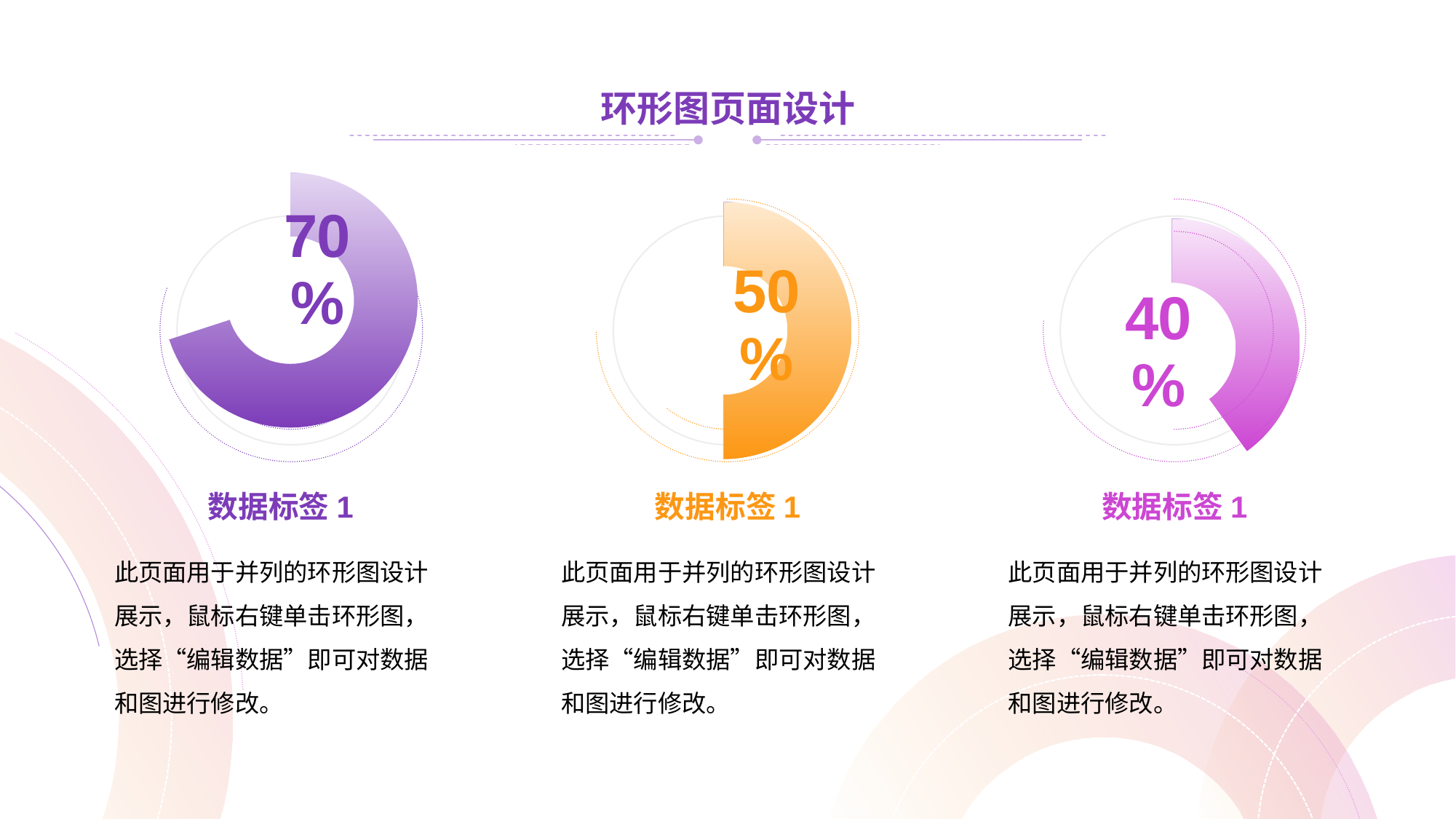
What value is shown in the right donut chart? 40% What is the title of the slide? 环形图页面设计 Which of the three donut charts shows the highest percentage? The left chart (70%) What value is shown in the middle donut chart? 50% What is the difference between the value in the left donut chart and the value in the right donut chart? 30% What kind of chart is used on this slide? Donut chart What is the difference between the value in the middle donut chart and the value in the right donut chart? 10% What value is shown in the left donut chart? 70% How many donut charts are on the slide? 3 Which of the three donut charts shows the lowest percentage? The right chart (40%) Is the value in the left donut chart larger or smaller than the value in the middle donut chart? Larger What colour is the filled portion of the middle donut chart? Orange